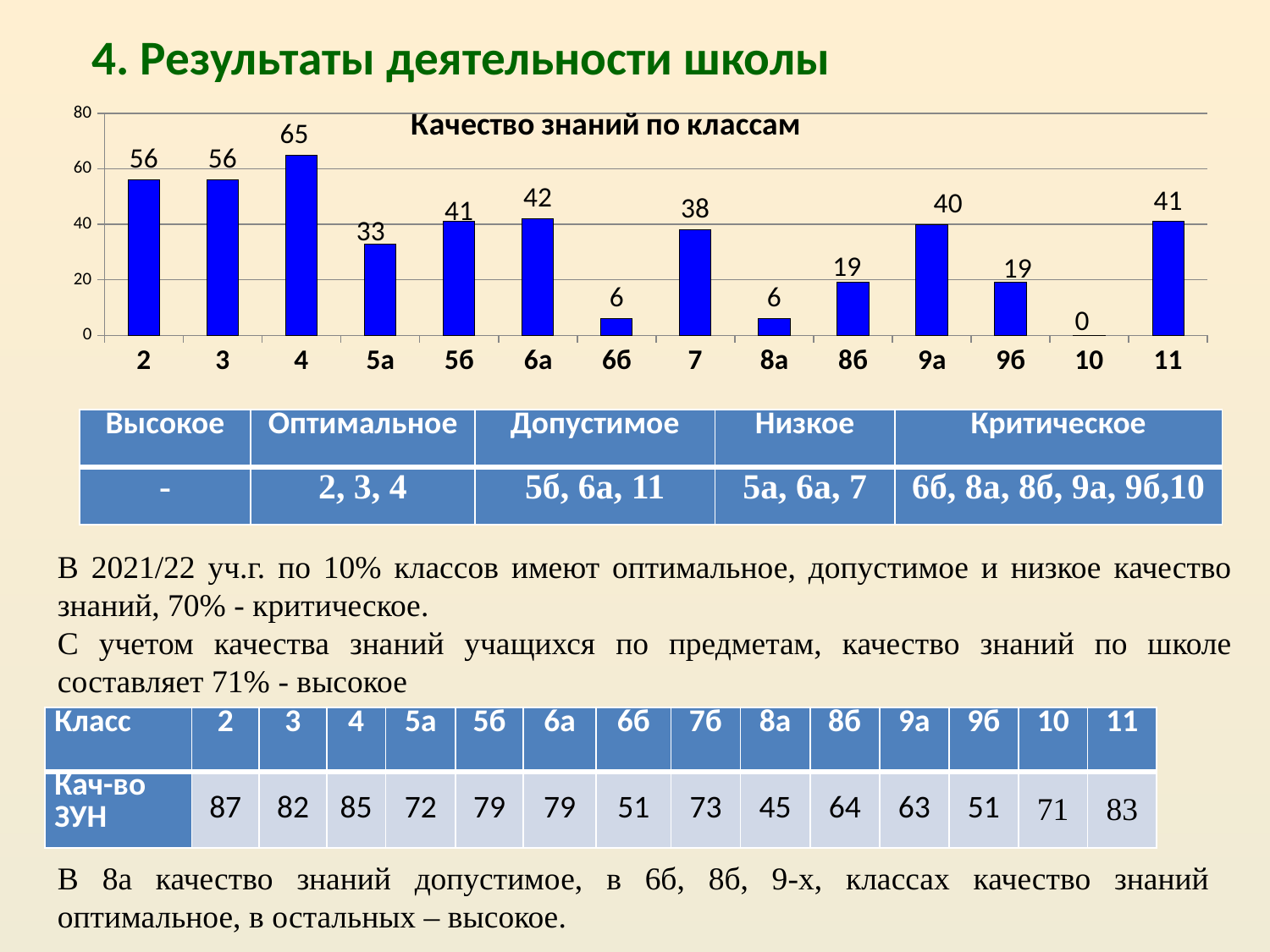
What is the value for class 8б in the chart? 19 What is the value for class 4 in the chart "Качество знаний по классам"? 65 What is the difference between the values for class 4 and class 7? 27 What is the title of the chart on the slide? Качество знаний по классам Which class has the highest value in the chart? 4 Which class has the lowest value in the chart? 10 What is the value for class 10 in the chart? 0 What kind of chart is "Качество знаний по классам"? bar chart How many classes are shown on the x axis of the chart? 14 Is the value for class 6а greater or less than 40? greater What is the value for class 5а in the chart? 33 Which is larger, the value for class 9а or the value for class 9б? 9а